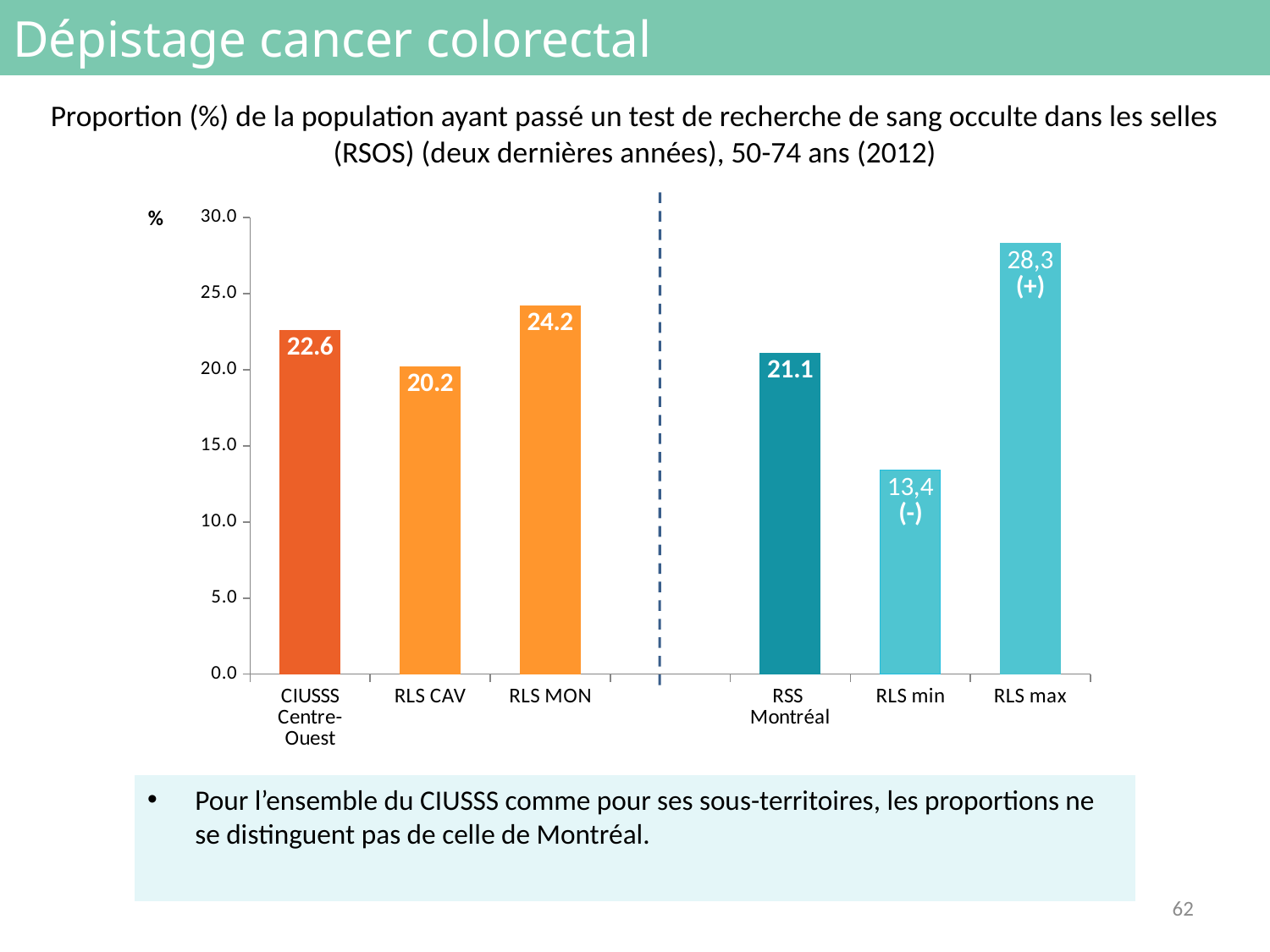
What is the value for RLS CAV? 20.2 Which category has the highest value? RLS max What is the value for RLS MON? 24.2 Is the value for RLS min greater or less than 15.0? less Which is larger, the value for CIUSSS Centre-Ouest or the value for RSS Montréal? CIUSSS Centre-Ouest How many bars are shown in the chart? 6 What kind of chart is shown on the slide? bar chart Which category has the lowest value? RLS min What is the value labelled on the RLS max bar? 28,3 What is the value for CIUSSS Centre-Ouest? 22.6 What is the difference between the values for RLS MON and RLS CAV? 4.0 What is the value for RSS Montréal? 21.1